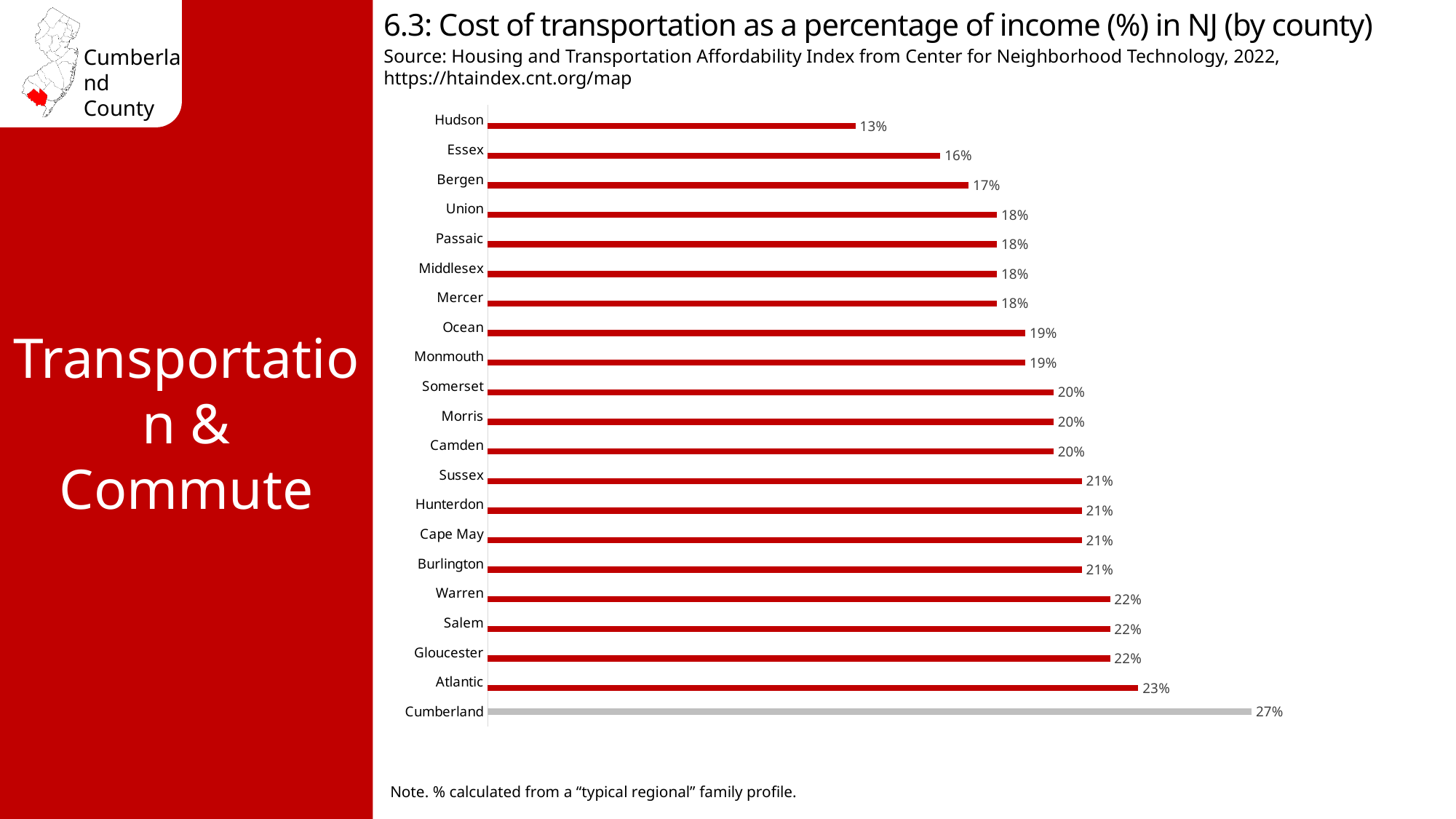
What is the value shown for Atlantic County? 23% Which county has the highest cost of transportation as a percentage of income? Cumberland What type of chart is shown on the slide? Bar chart What is the value shown for Somerset County? 20% What is the cost of transportation as a percentage of income for Hudson County? 13% Which county's bar is shown in a different colour (grey) from the others? Cumberland How many counties are shown in the chart? 21 Which county has the lowest cost of transportation as a percentage of income? Hudson Which county has a higher value, Bergen or Warren? Warren What is the cost of transportation as a percentage of income for Cumberland County? 27% What is the difference in percentage points between Atlantic and Essex? 7 What is the difference in percentage points between Cumberland and Hudson? 14